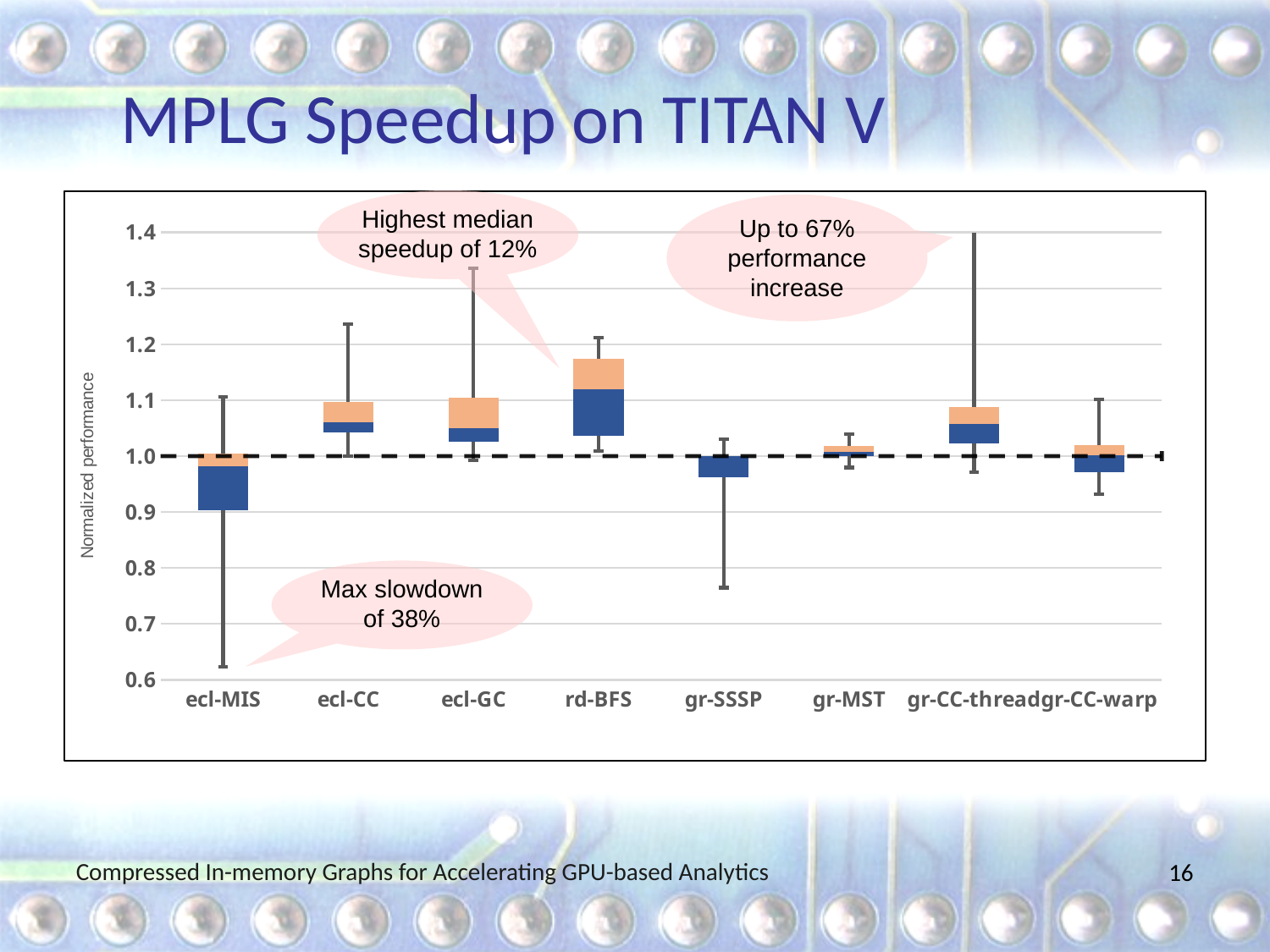
What is the label of the y axis of the chart? Normalized performance Is the lower whisker for gr-SSSP greater or less than 0.8? less How many categories are shown along the x axis of the chart? 8 Is the upper whisker for gr-MST greater or less than 1.1? less Is the upper whisker for ecl-CC greater or less than 1.2? greater At what y-axis value is the horizontal dashed reference line drawn? 1.0 Which category has the lowest lower whisker in the chart? ecl-MIS Which category has the highest upper whisker in the chart? gr-CC-thread What kind of chart is shown on the slide? Box-and-whisker plot Which category has a higher upper whisker, ecl-GC or gr-CC-warp? ecl-GC